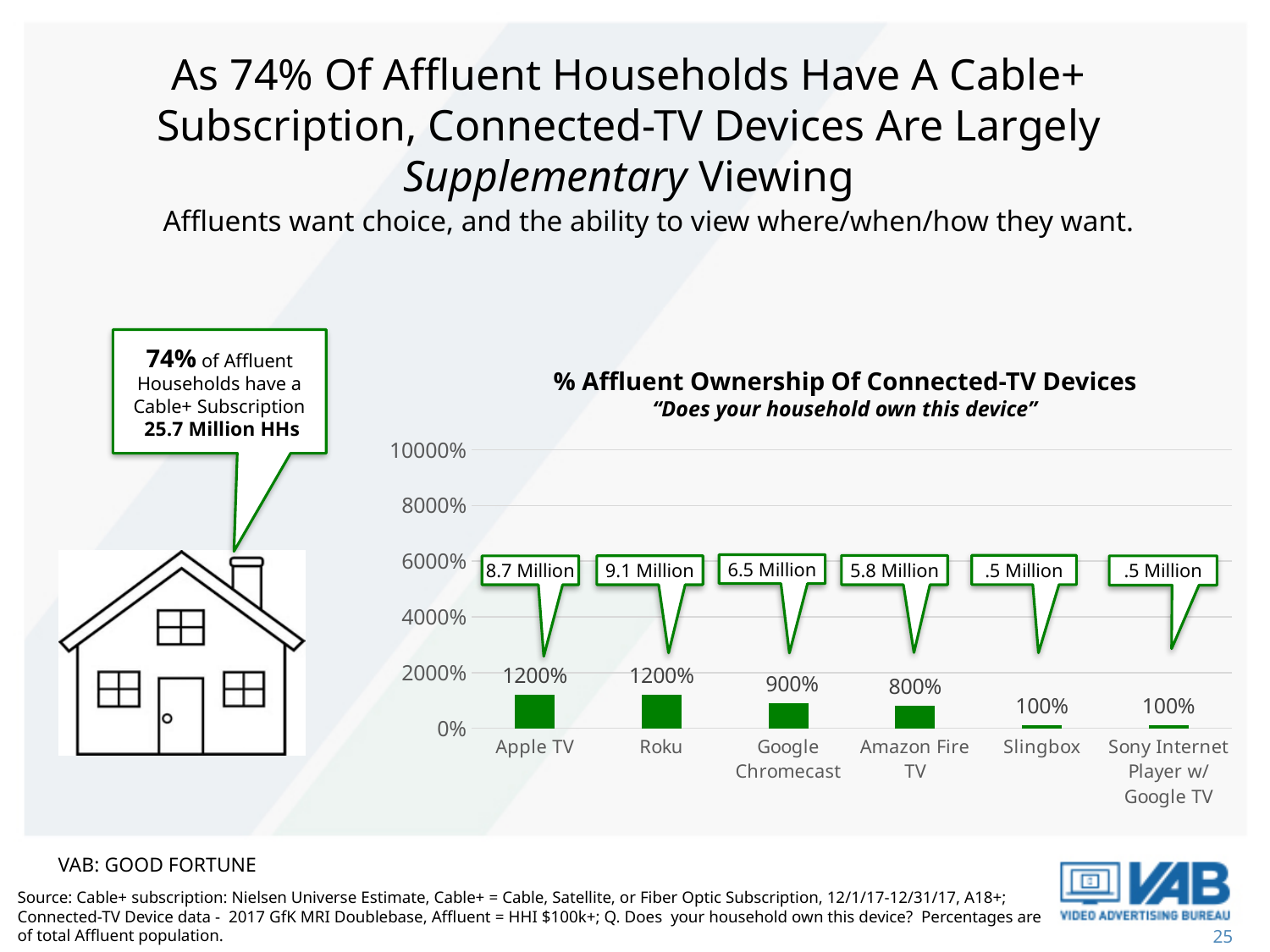
What is the value for Amazon Fire TV in the chart? 800% According to the callout above the Roku bar, how many affluent households own a Roku? 9.1 Million What is the difference between the values for Apple TV and Google Chromecast? 300% What is the title of the chart? % Affluent Ownership Of Connected-TV Devices How many device categories are shown on the x axis of the chart? 6 What is the difference between the values for Roku and Amazon Fire TV? 400% According to the callout above the Google Chromecast bar, how many affluent households own a Google Chromecast? 6.5 Million What is the value for Apple TV in the chart? 1200% What is the value for Slingbox in the chart? 100% What kind of chart is shown on the slide? Bar chart Which has a larger value, Google Chromecast or Amazon Fire TV? Google Chromecast What is the value for Google Chromecast in the chart? 900%